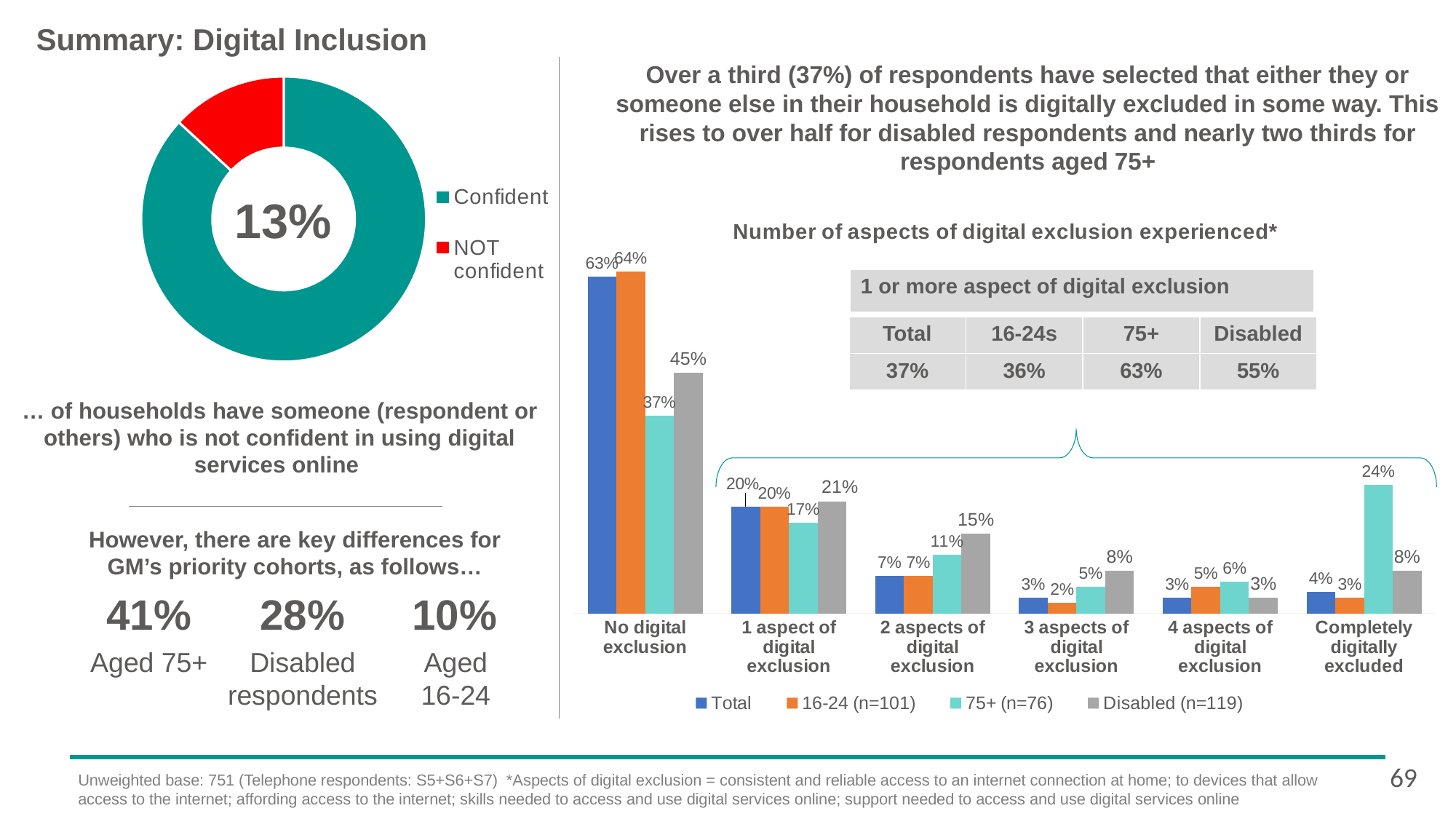
In the bar chart titled 'Number of aspects of digital exclusion experienced', what is the value for the Total series in the 'No digital exclusion' category? 63% How many series does the legend of the bar chart titled 'Number of aspects of digital exclusion experienced' list? 4 In the bar chart titled 'Number of aspects of digital exclusion experienced', which is larger in the 'No digital exclusion' category: the 75+ (n=76) value or the Disabled (n=119) value? Disabled (n=119) In the bar chart titled 'Number of aspects of digital exclusion experienced', which series has the highest value in the 'No digital exclusion' category? 16-24 (n=101) In the bar chart titled 'Number of aspects of digital exclusion experienced', what is the value for the 75+ (n=76) series in the 'Completely digitally excluded' category? 24% How many categories are shown on the x axis of the bar chart titled 'Number of aspects of digital exclusion experienced'? 6 In the bar chart titled 'Number of aspects of digital exclusion experienced', which series has the lowest value in the '3 aspects of digital exclusion' category? 16-24 (n=101) In the bar chart titled 'Number of aspects of digital exclusion experienced', what is the value for the Disabled (n=119) series in the '2 aspects of digital exclusion' category? 15% In the donut chart on the left of the slide, what percentage is shown in the centre for the NOT confident share? 13% What kind of chart is the chart titled 'Number of aspects of digital exclusion experienced'? Bar chart In the bar chart titled 'Number of aspects of digital exclusion experienced', what is the difference between the 75+ (n=76) value and the Total value in the 'Completely digitally excluded' category? 20% What kind of chart is the chart on the left of the slide with the 'Confident' and 'NOT confident' legend? Donut chart